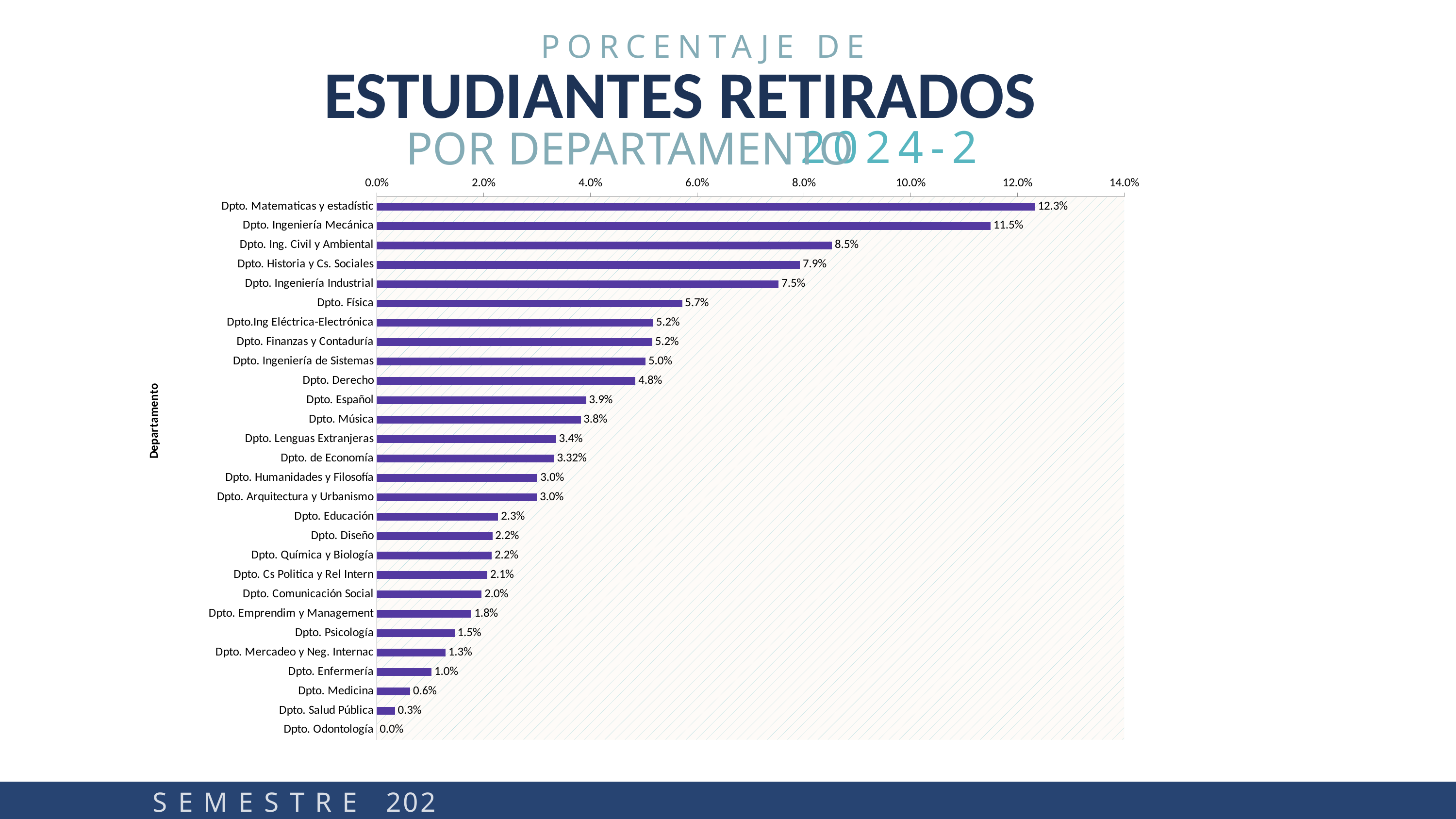
What is the difference between Dpto. Matematicas y estadístic and Dpto. Ingeniería Mecánica? 0.8% Which department has the lowest percentage? Dpto. Odontología What is the value for Dpto. de Economía? 3.32% Which is larger, the value for Dpto. Física or the value for Dpto. Ingeniería Industrial? Dpto. Ingeniería Industrial Which department has the highest percentage? Dpto. Matematicas y estadístic What is the label of the vertical axis? Departamento What kind of chart is shown on the slide? bar chart Is the value for Dpto. Ing. Civil y Ambiental greater or less than 8.0%? greater What is the value for Dpto. Salud Pública? 0.3% What is the value for Dpto. Ingeniería Mecánica? 11.5% What is the value for Dpto. Derecho? 4.8% How many departments are shown in the chart? 28